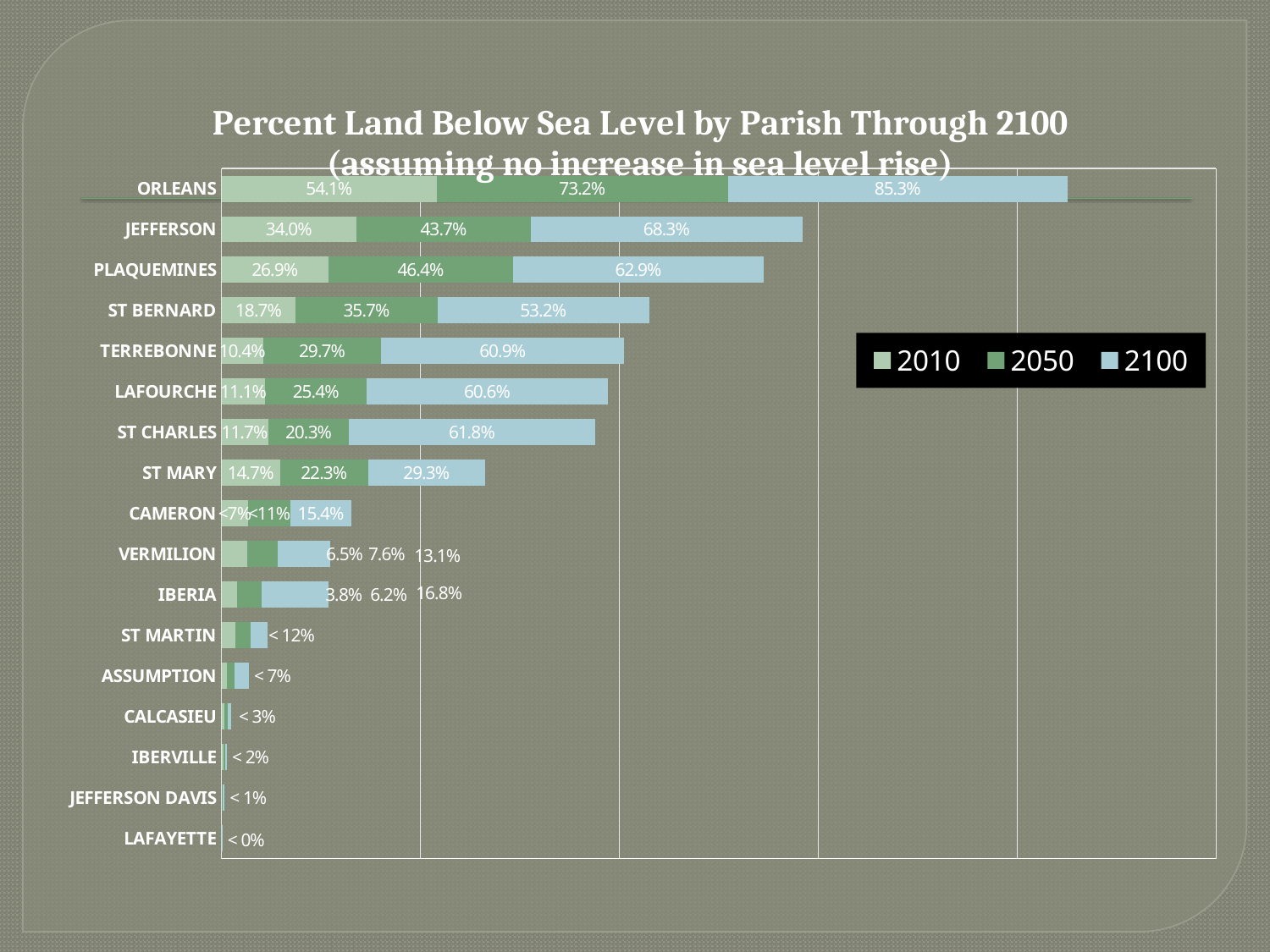
What is the 2050 value for St Mary? 22.3% What is the difference between the 2100 and 2010 values for Orleans? 31.2 percentage points How many series does the legend list? 3 Which parish has the highest 2100 value? Orleans What kind of chart is shown? Stacked bar chart What is the 2050 value for Plaquemines? 46.4% What is the 2100 value for Orleans? 85.3% What is the difference between the 2100 and 2050 values for Jefferson? 24.6 percentage points What is the 2010 value for Jefferson? 34.0% Which is larger, the 2100 value for St Bernard or the 2100 value for St Charles? St Charles What are the three series listed in the legend? 2010, 2050, 2100 How many parishes are shown on the chart? 17